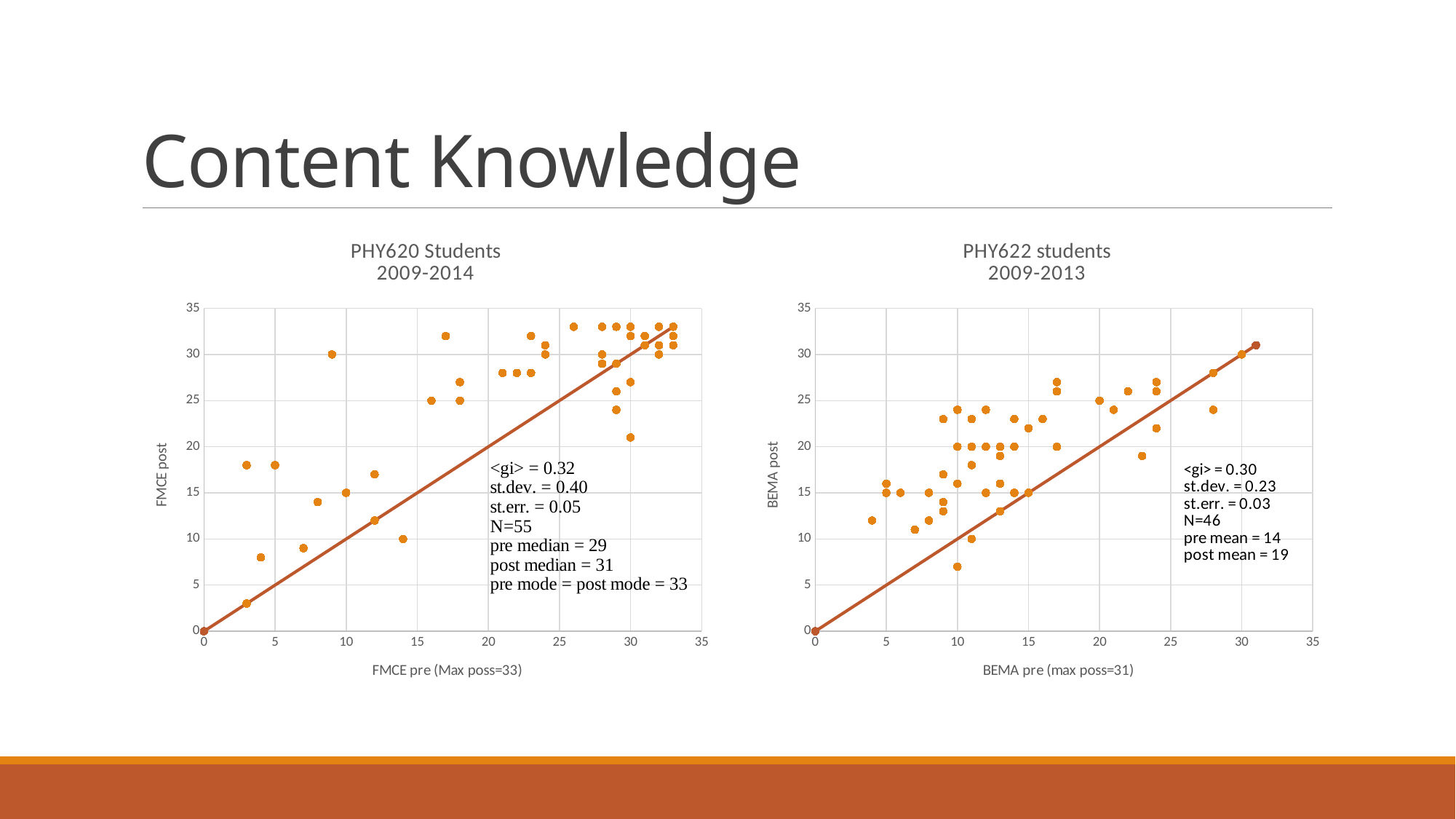
What kind of chart is the PHY620 Students 2009-2014 chart on the left? scatter chart In the PHY620 Students chart, what is the <gi> value shown? 0.32 In the PHY620 Students chart, what is the value of N shown in the annotation? N=55 In the PHY622 students chart, what is the post mean shown? 19 What is the y-axis title of the PHY622 students chart? BEMA post What kind of chart is the PHY622 students 2009-2013 chart on the right? scatter chart What is the difference between the st.dev. values reported on the PHY620 Students chart and the PHY622 students chart? 0.17 Which chart reports the larger <gi> value, PHY620 Students or PHY622 students? PHY620 Students What is the x-axis title of the PHY620 Students chart? FMCE pre (Max poss=33) In the PHY622 students chart, what is the value of N shown in the annotation? N=46 In the PHY620 Students chart, what is the pre median shown? 29 In the PHY620 Students chart, is the highest FMCE post value plotted greater or less than 30? greater